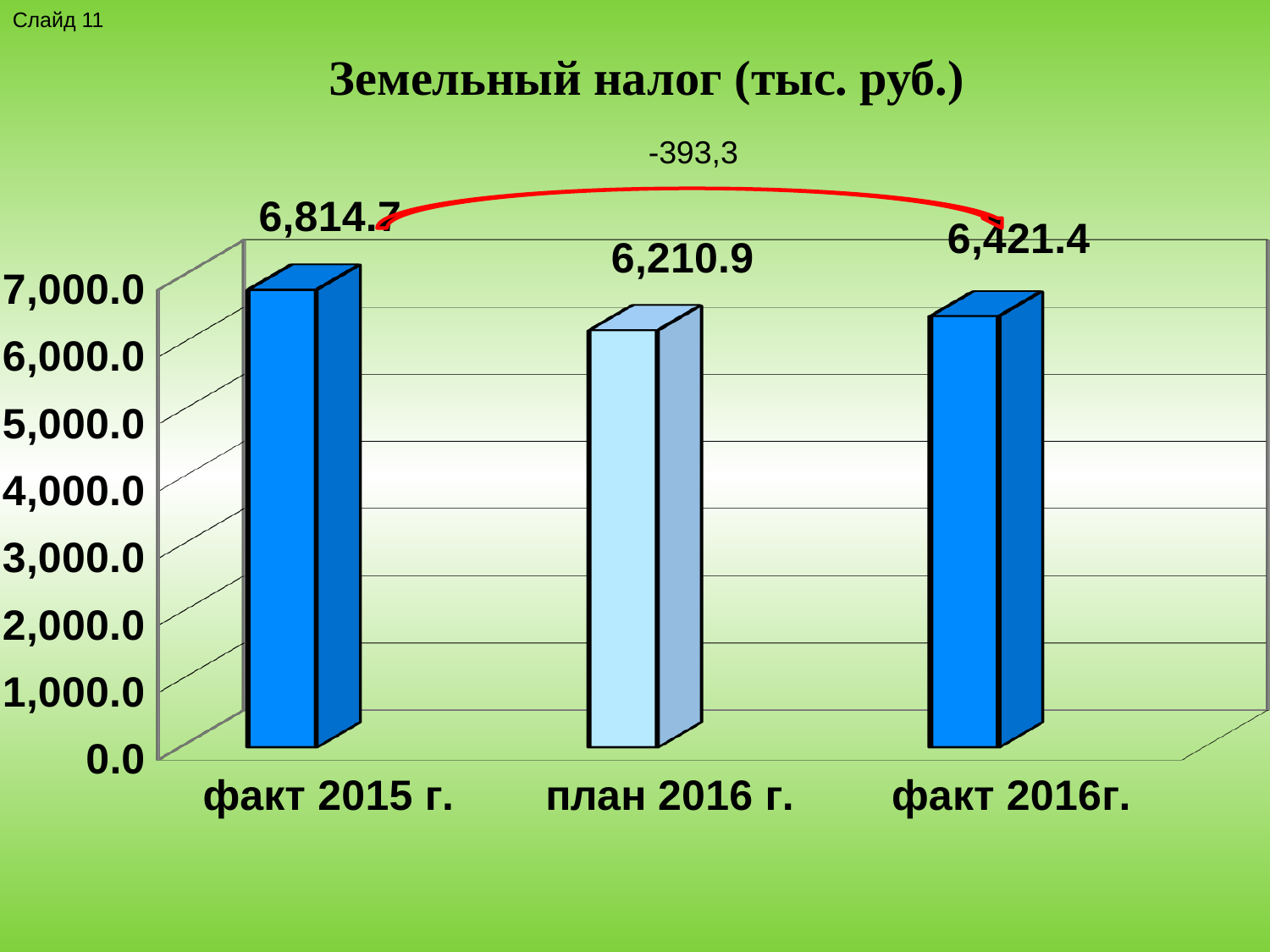
What is the value for факт 2015 г.? 6,814.7 Which category has the lowest value? план 2016 г. Is the value for план 2016 г. greater or less than 7,000.0? less What kind of chart is shown on the slide? bar chart What is the difference between the values for факт 2015 г. and факт 2016г.? 393.3 What is the value for факт 2016г.? 6,421.4 How many categories are shown on the chart? 3 What is the title of the chart? Земельный налог (тыс. руб.) Which category has the highest value? факт 2015 г. Which is larger, the value for план 2016 г. or the value for факт 2016г.? факт 2016г. What is the difference between the values for факт 2016г. and план 2016 г.? 210.5 What is the value for план 2016 г.? 6,210.9